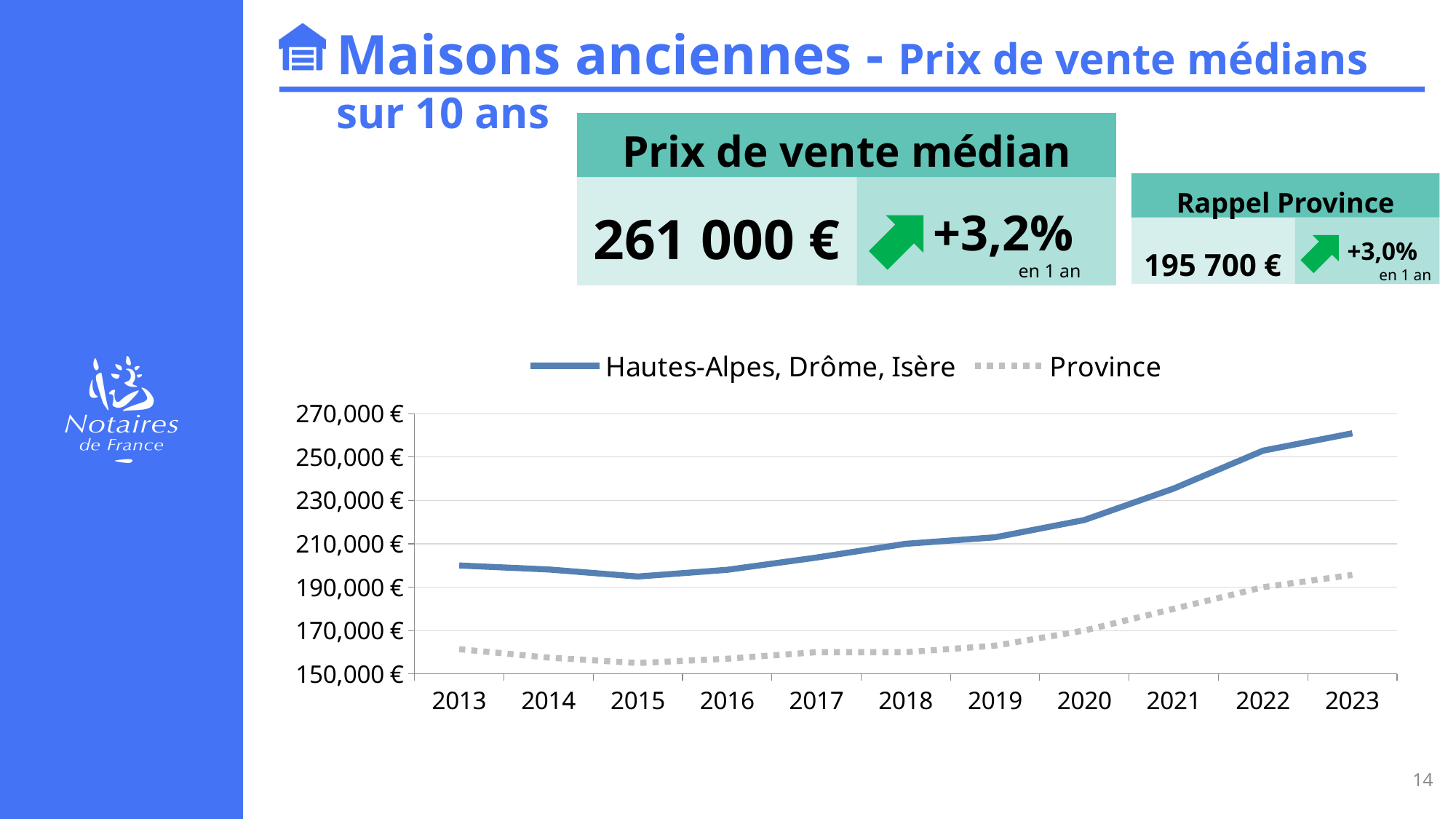
In which year is the Hautes-Alpes, Drôme, Isère line at its lowest? 2015 Which series is drawn with a dotted grey line in the chart? Province Overall, do the values of the Hautes-Alpes, Drôme, Isère line rise or fall from 2015 to 2023? rise Which series has the higher value in 2023, Hautes-Alpes, Drôme, Isère or Province? Hautes-Alpes, Drôme, Isère Is the value for Province in 2015 greater or less than 170,000 €? less How many series does the chart legend list? 2 Is the value for Hautes-Alpes, Drôme, Isère in 2015 greater or less than 210,000 €? less How many years are plotted along the x axis of the chart? 11 Is the value for Hautes-Alpes, Drôme, Isère in 2022 greater or less than 230,000 €? greater What kind of chart is shown on the slide? line chart In which year is the Province line at its highest? 2023